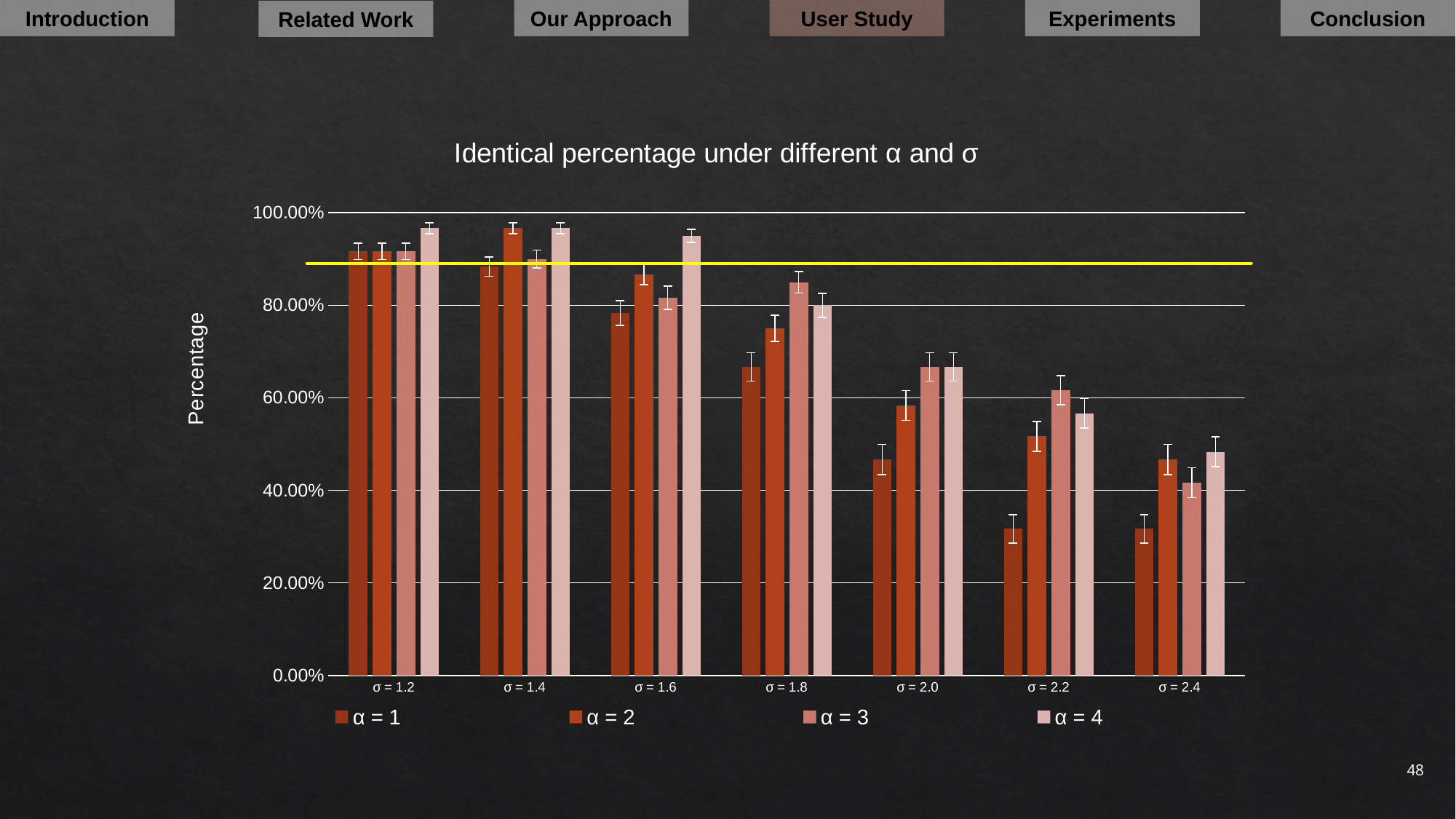
Is the value for α = 4 at σ = 1.2 greater or less than 80.00%? greater What is the label of the y axis? Percentage What is the title of the chart? Identical percentage under different α and σ Do the values for α = 1 rise or fall as σ increases from 1.2 to 2.4? fall Is the value for α = 2 at σ = 1.8 greater or less than 80.00%? less How many σ categories are shown on the x axis? 7 At σ = 2.2, which is larger: the value for α = 1 or the value for α = 4? α = 4 Is the value for α = 3 at σ = 1.8 greater or less than 80.00%? greater How many series does the legend list? 4 What kind of chart is shown on the slide? bar chart At σ = 2.0, which α series has the lowest value? α = 1